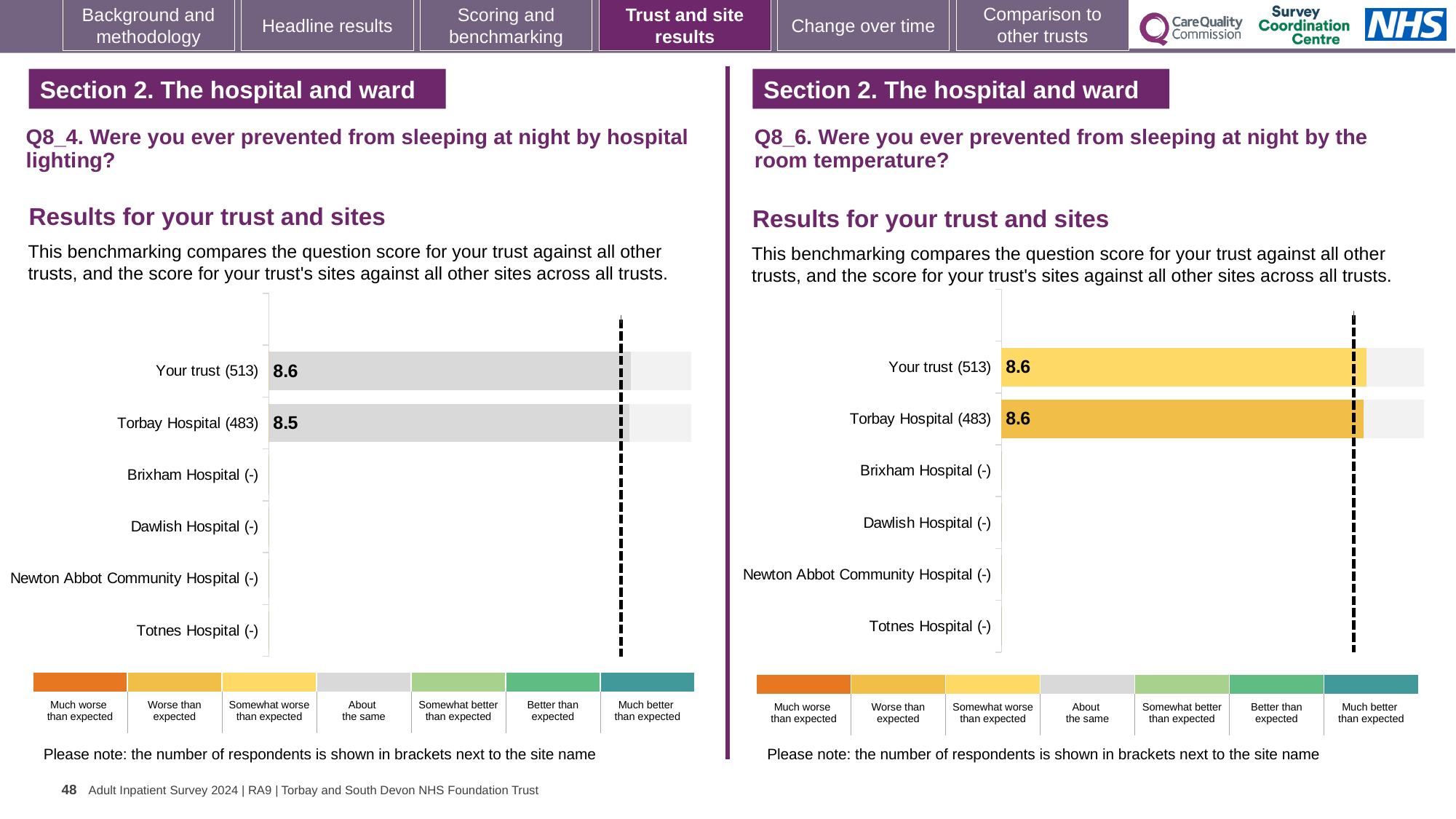
On the Q8_4 hospital lighting chart, what is the score for Your trust (513)? 8.6 What kind of chart is used on the Q8_6 room temperature chart? Bar chart On the Q8_6 room temperature chart, what is the score for Your trust (513)? 8.6 On the Q8_4 hospital lighting chart, what is the difference between the Your trust score and the Torbay Hospital score? 0.1 On the Q8_4 hospital lighting chart, which benchmark category does the colour of the Your trust bar correspond to in the key? About the same On the Q8_4 hospital lighting chart, what is the score for Torbay Hospital (483)? 8.5 On the Q8_6 room temperature chart, which benchmark category does the colour of the Your trust bar correspond to in the key? Somewhat worse than expected On the Q8_6 room temperature chart, how many categories have a plotted bar? 2 How many site or trust categories are listed on the Q8_4 hospital lighting chart? 6 On the Q8_4 hospital lighting chart, how many respondents are shown for Torbay Hospital? 483 On the Q8_6 room temperature chart, what is the score for Torbay Hospital (483)? 8.6 On the Q8_4 hospital lighting chart, which has the higher score, Your trust or Torbay Hospital? Your trust